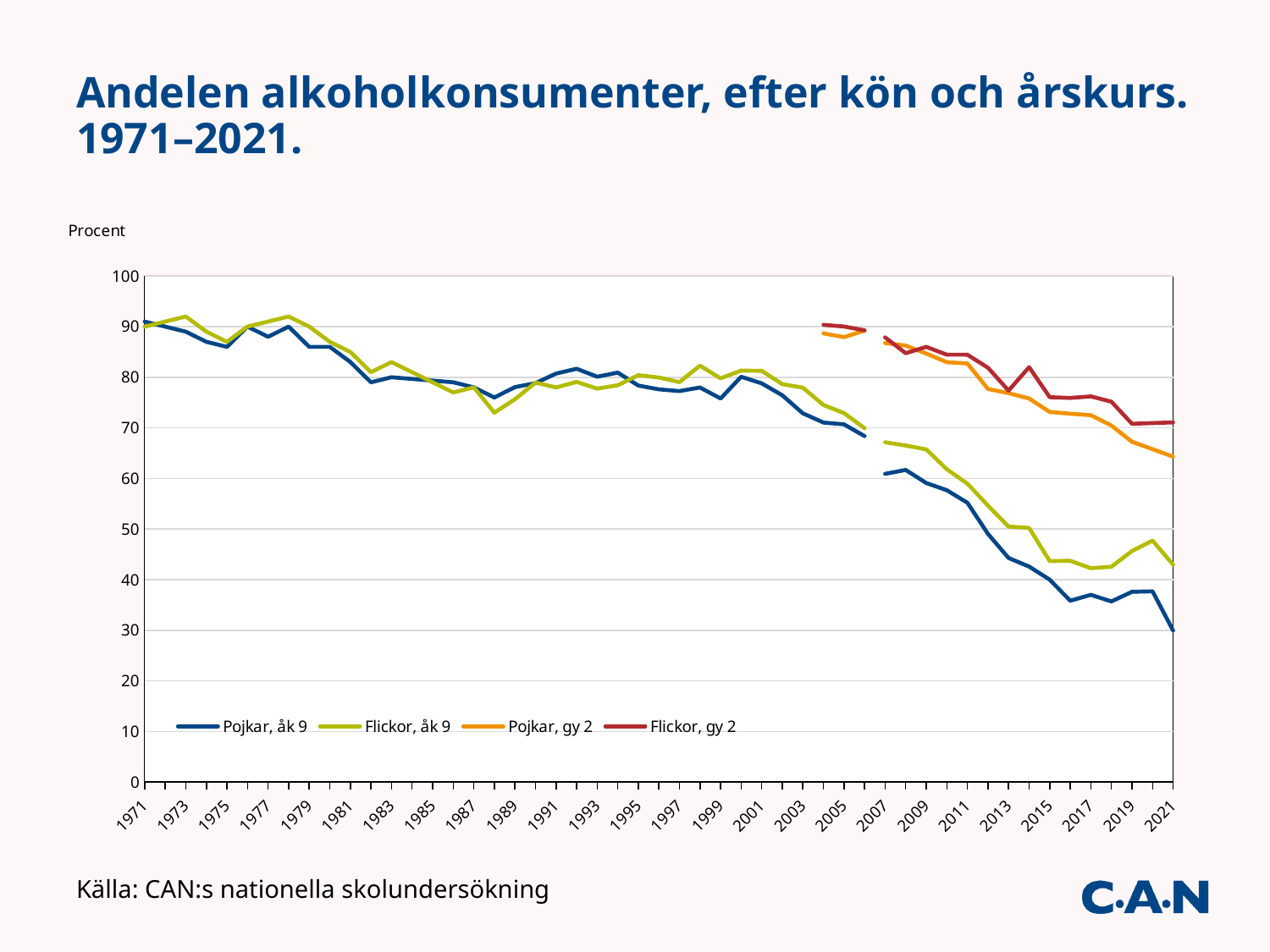
In 2021, which is higher: Flickor, åk 9 or Pojkar, åk 9? Flickor, åk 9 Is the value for Flickor, gy 2 in 2021 greater or less than 60? greater Does the value for Flickor, gy 2 rise or fall from 2007 to 2021? Fall Which series has the highest value in 2021? Flickor, gy 2 What is the title of the chart? Andelen alkoholkonsumenter, efter kön och årskurs. 1971–2021. Does the value for Pojkar, åk 9 rise or fall from 1971 to 2021? Fall Is the value for Pojkar, åk 9 in 2021 greater or less than 40? less How many series does the legend list? 4 Is the value for Pojkar, åk 9 in 1971 greater or less than 80? greater What are the series names listed in the legend? Pojkar, åk 9; Flickor, åk 9; Pojkar, gy 2; Flickor, gy 2 What kind of chart is shown on the slide? Line chart